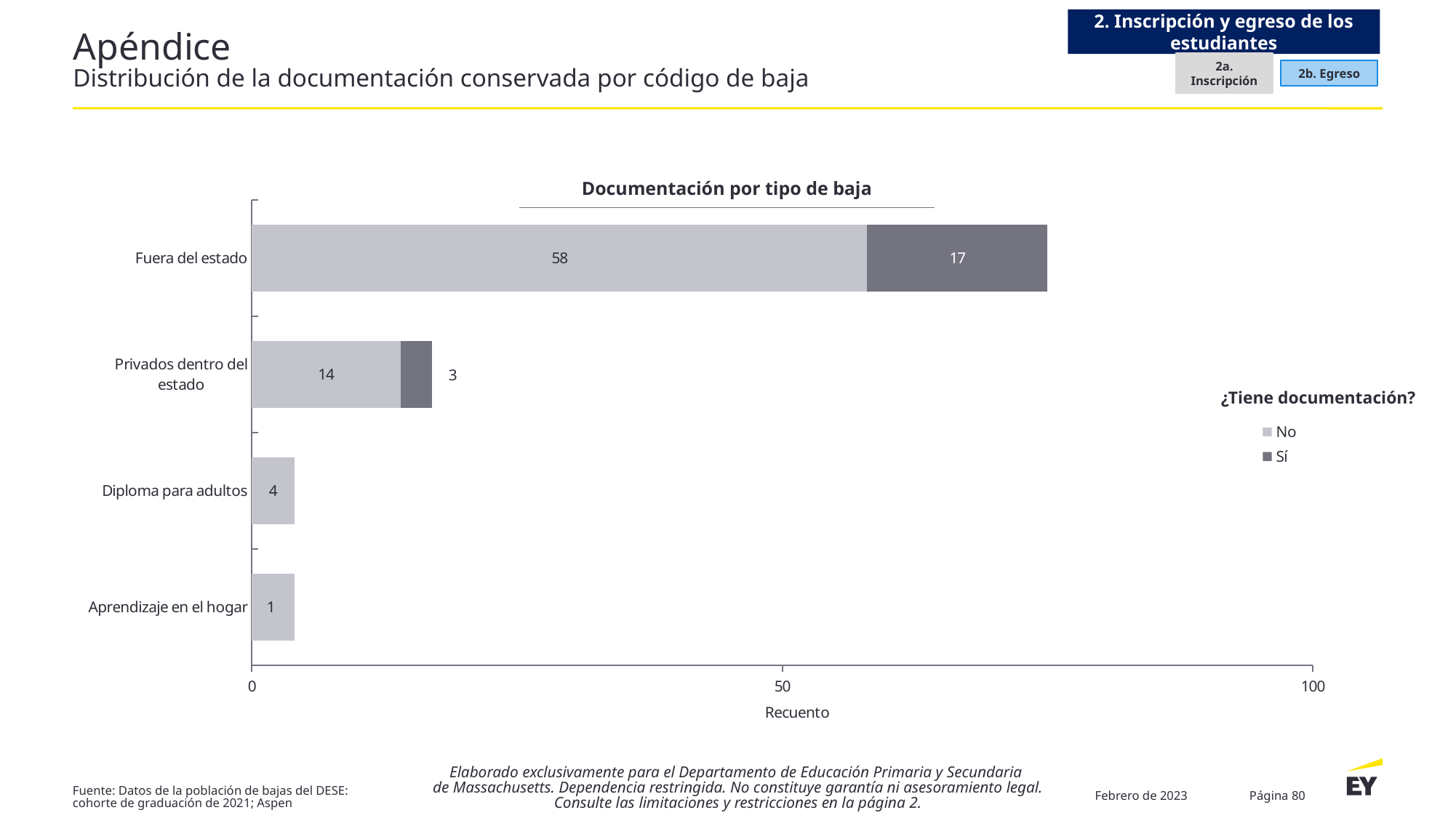
What kind of chart is shown? Bar chart How many series does the legend list? 2 What is the 'No' value for Privados dentro del estado? 14 What is the 'Sí' value for Fuera del estado? 17 What is the 'Sí' value for Privados dentro del estado? 3 What is the value shown for Diploma para adultos? 4 What is the total of the stacked bar for Privados dentro del estado? 17 What is the 'No' value for Fuera del estado? 58 What is the total of the stacked bar for Fuera del estado? 75 What is the difference between the 'No' and 'Sí' values for Fuera del estado? 41 Which category has the lowest value? Aprendizaje en el hogar Which category has the highest total? Fuera del estado